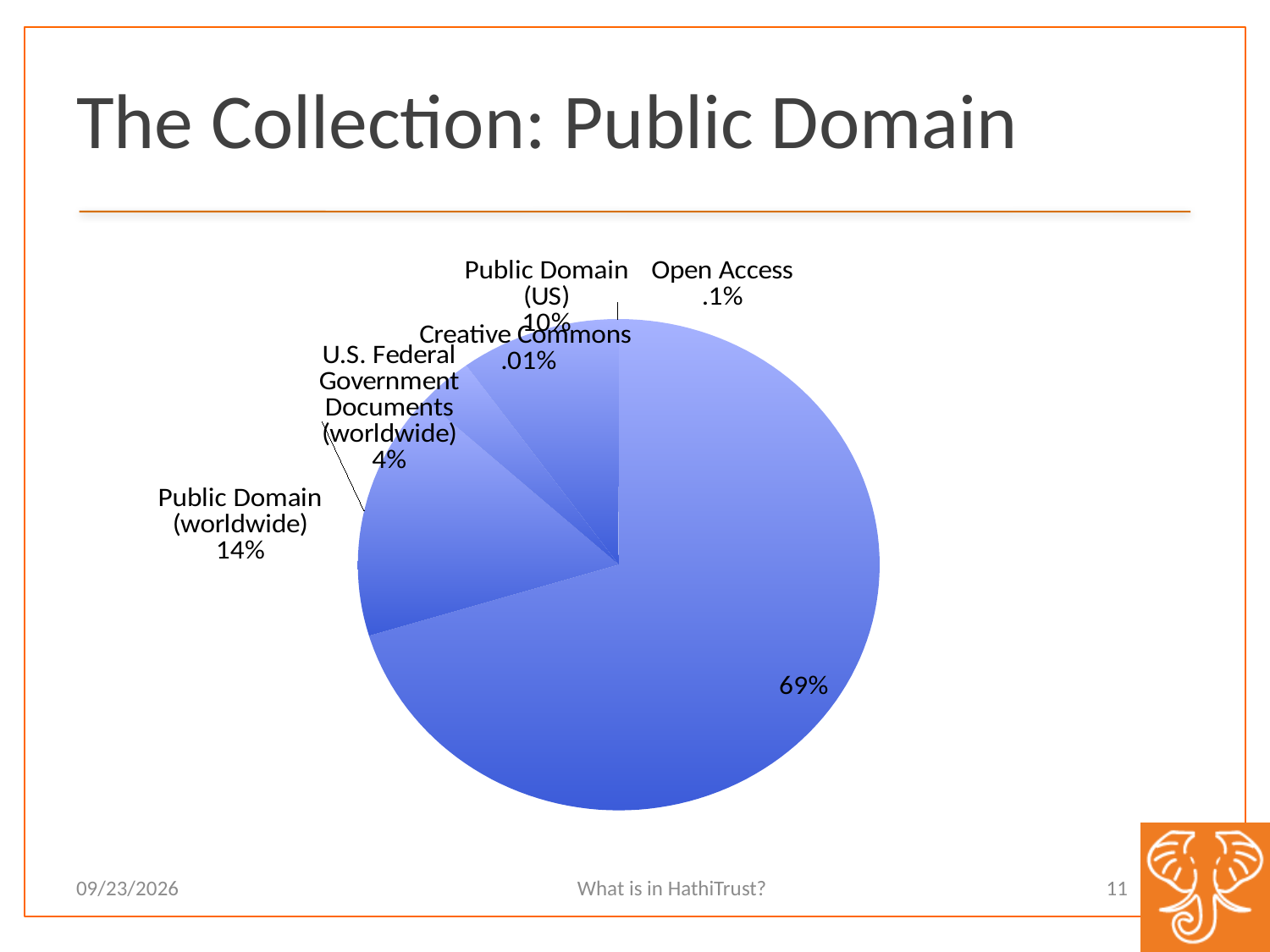
What is the title of the slide containing the chart? The Collection: Public Domain What kind of chart is shown on the slide? pie chart What percentage is printed on the largest slice of the pie? 69% What share of the pie is Public Domain (US)? 10% How many slices does the pie chart have? 6 Which is larger: the share for Public Domain (worldwide) or Public Domain (US)? Public Domain (worldwide) Which labeled category has the smallest share of the pie? Creative Commons What share of the pie is Open Access? .1% What share of the pie is U.S. Federal Government Documents (worldwide)? 4% What share of the pie is Public Domain (worldwide)? 14% What is the difference in percentage points between Public Domain (worldwide) and Public Domain (US)? 4% What share of the pie is Creative Commons? .01%